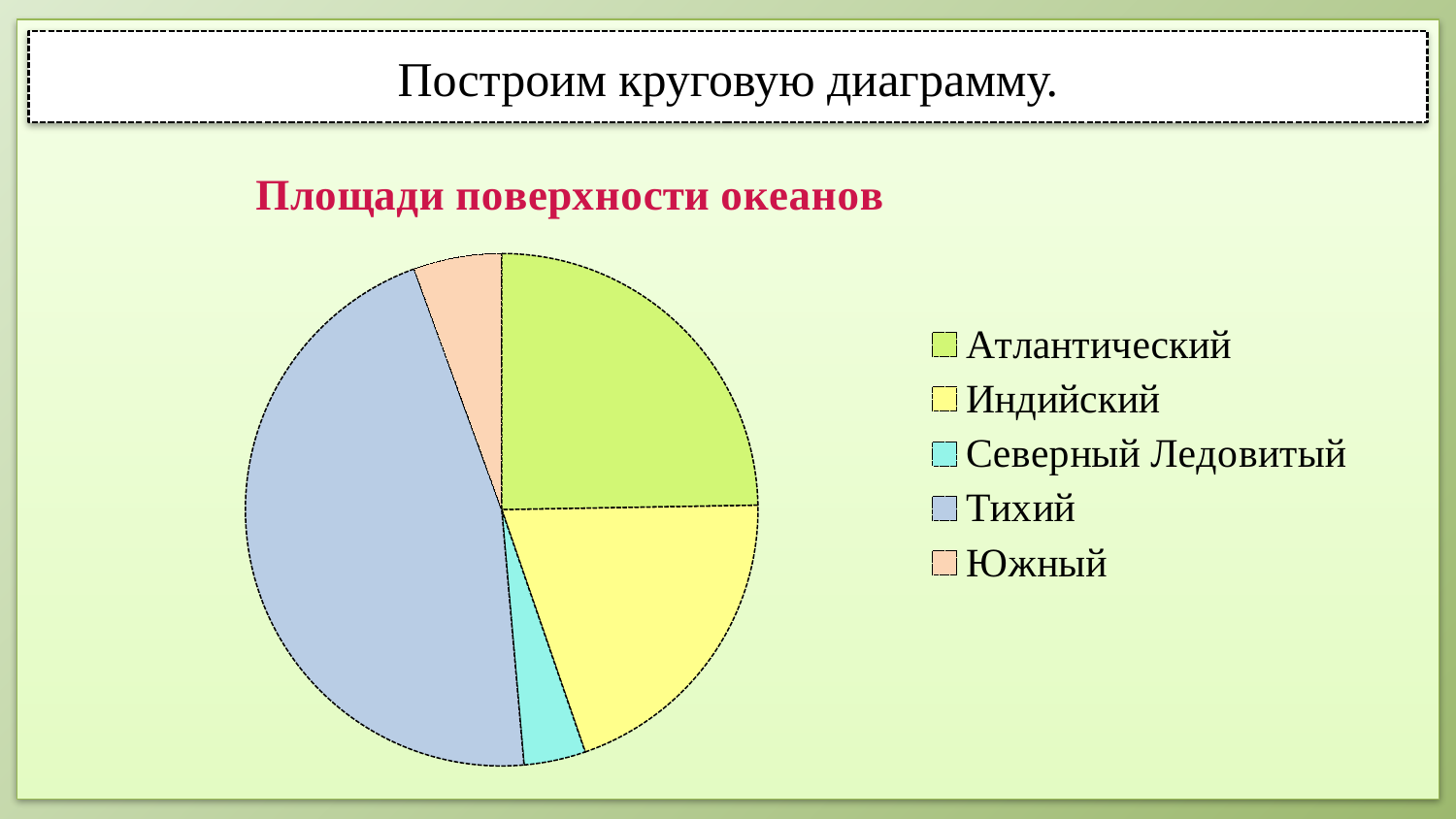
What is the title of the pie chart? Площади поверхности океанов Which slice is larger, Атлантический or Индийский? Атлантический How many oceans (slices) does the pie chart show? 5 Which slice is larger, Тихий or Атлантический? Тихий Which slice is larger, Индийский or Южный? Индийский Which ocean is represented by the cyan slice in the pie chart? Северный Ледовитый What type of chart is shown on the slide? pie chart Which ocean has the smallest slice in the pie chart? Северный Ледовитый Which ocean has the largest slice in the pie chart? Тихий